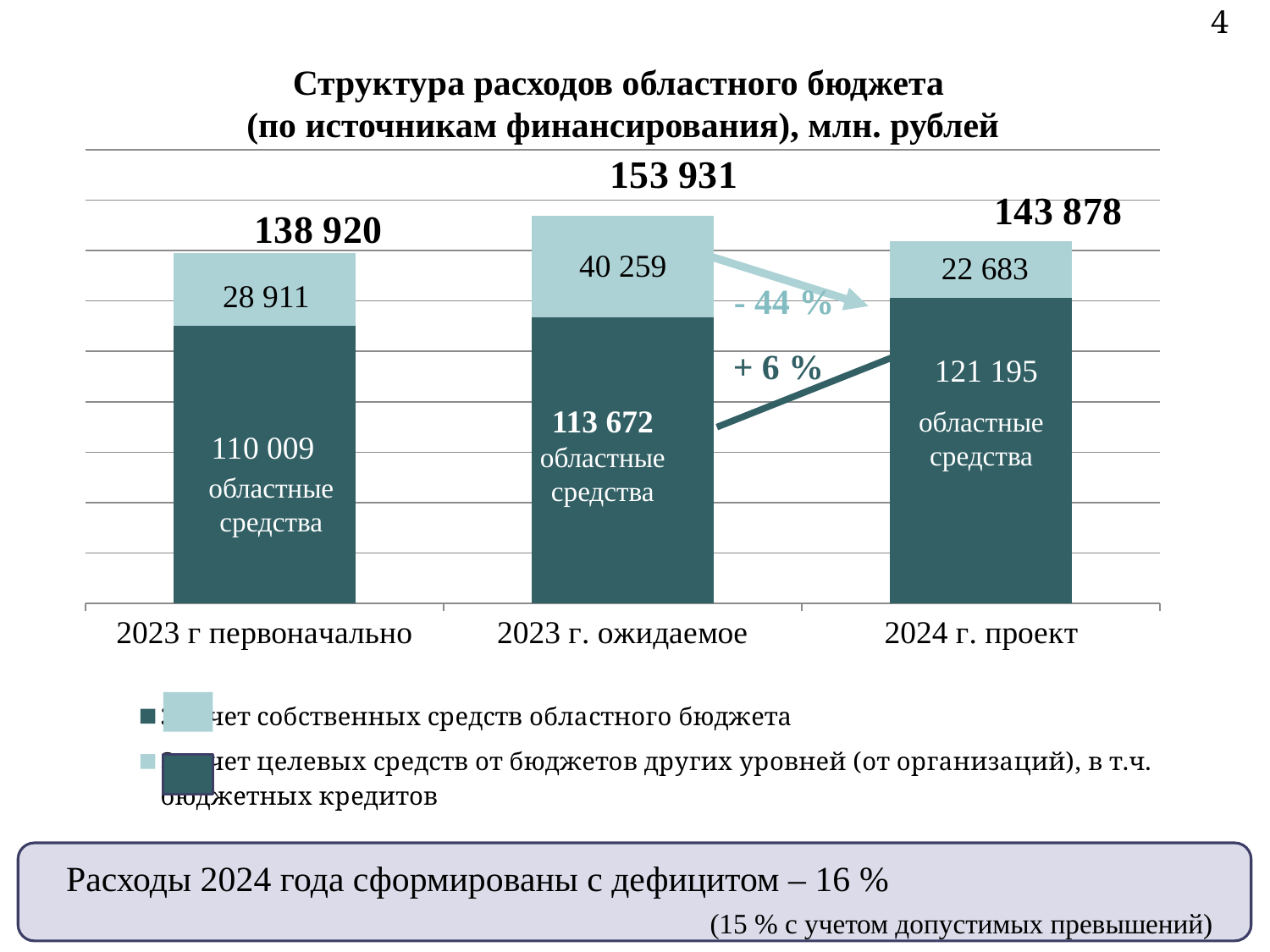
What percentage change is shown by the arrow between the upper segments of "2023 г. ожидаемое" and "2024 г. проект"? - 44 % What is the value of the "областные средства" segment for "2024 г. проект"? 121 195 Which is larger: the upper (light) segment for "2023 г. ожидаемое" or for "2024 г. проект"? 2023 г. ожидаемое Which category has the highest total value? 2023 г. ожидаемое What is the value of the upper (light) segment for "2023 г первоначально"? 28 911 What is the difference between the total for "2023 г. ожидаемое" and the total for "2024 г. проект"? 10 053 What is the title of the chart? Структура расходов областного бюджета (по источникам финансирования), млн. рублей How many categories are shown on the x axis? 3 What is the total value shown above the bar for "2023 г. ожидаемое"? 153 931 Which category has the lowest total value? 2023 г первоначально What kind of chart is shown on the slide? Stacked bar chart How many series does the legend list? 2